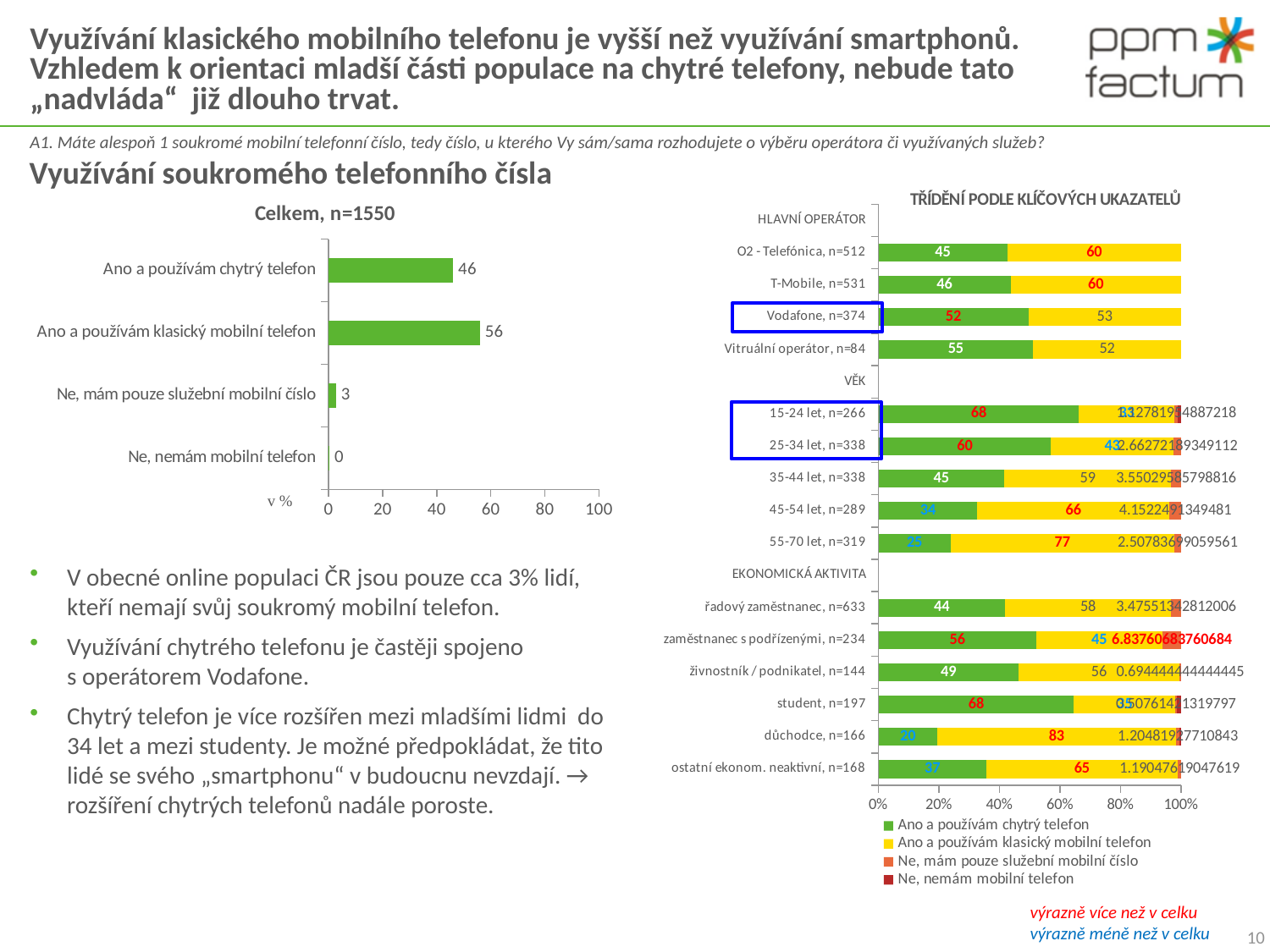
How many series does the legend of the 'TŘÍDĚNÍ PODLE KLÍČOVÝCH UKAZATELŮ' chart list? 4 In the 'TŘÍDĚNÍ PODLE KLÍČOVÝCH UKAZATELŮ' chart, what is the value of 'Ano a používám chytrý telefon' for '15-24 let, n=266'? 68 In the 'TŘÍDĚNÍ PODLE KLÍČOVÝCH UKAZATELŮ' chart, which is larger for 'Vodafone, n=374': 'Ano a používám chytrý telefon' or 'Ano a používám klasický mobilní telefon'? Ano a používám klasický mobilní telefon In the 'Celkem, n=1550' chart, what is the value for 'Ano a používám chytrý telefon'? 46 In the 'TŘÍDĚNÍ PODLE KLÍČOVÝCH UKAZATELŮ' chart, what is the value of 'Ano a používám klasický mobilní telefon' for 'důchodce, n=166'? 83 In the 'Celkem, n=1550' chart, which category has the lowest value? Ne, nemám mobilní telefon In the 'Celkem, n=1550' chart, what is the difference between the values for 'Ano a používám klasický mobilní telefon' and 'Ano a používám chytrý telefon'? 10 In the 'Celkem, n=1550' chart, what is the value for 'Ano a používám klasický mobilní telefon'? 56 In the 'Celkem, n=1550' chart, which category has the highest value? Ano a používám klasický mobilní telefon In the 'Celkem, n=1550' chart, how many categories are shown? 4 In the 'TŘÍDĚNÍ PODLE KLÍČOVÝCH UKAZATELŮ' chart, what is the value of 'Ano a používám chytrý telefon' for 'O2 - Telefónica, n=512'? 45 What kind of chart is the 'Celkem, n=1550' chart? bar chart